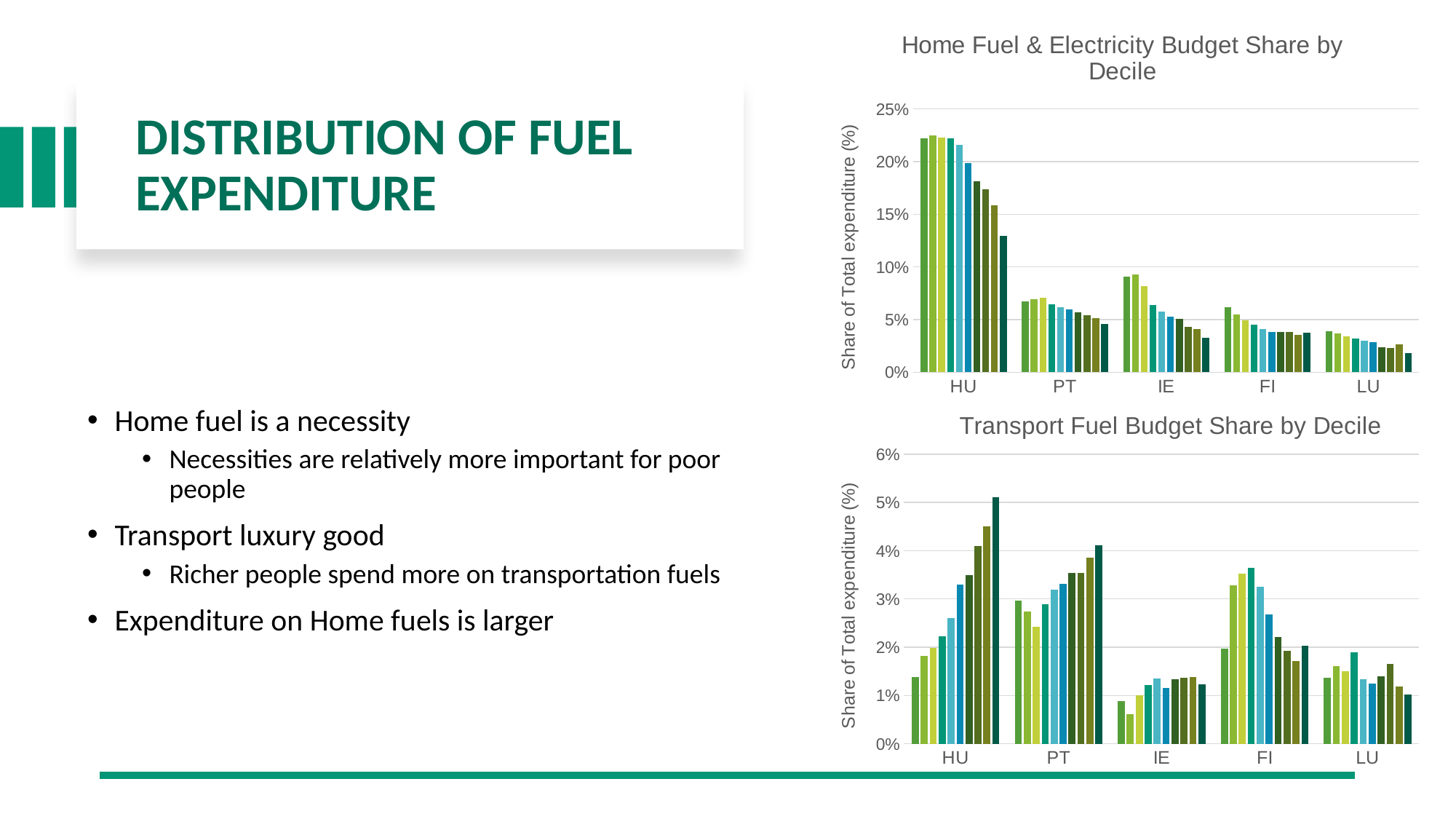
In the 'Home Fuel & Electricity Budget Share by Decile' chart, do the HU bars rise or fall from left to right across the deciles? fall In the 'Transport Fuel Budget Share by Decile' chart, do the HU bars rise or fall from left to right across the deciles? rise In the 'Home Fuel & Electricity Budget Share by Decile' chart, which country has the tallest bars? HU What is the y-axis label of the 'Transport Fuel Budget Share by Decile' chart? Share of Total expenditure (%) In the 'Home Fuel & Electricity Budget Share by Decile' chart, are all the LU bars greater or less than 5%? less In the 'Transport Fuel Budget Share by Decile' chart, which country has the single tallest bar? HU In the 'Transport Fuel Budget Share by Decile' chart, are all the IE bars greater or less than 2%? less In the 'Transport Fuel Budget Share by Decile' chart, is the tallest FI bar greater or less than 3%? greater In the 'Home Fuel & Electricity Budget Share by Decile' chart, which country has the lowest bars overall? LU What type of chart is the 'Home Fuel & Electricity Budget Share by Decile' chart? bar chart How many country categories are shown on the x axis of the 'Transport Fuel Budget Share by Decile' chart? 5